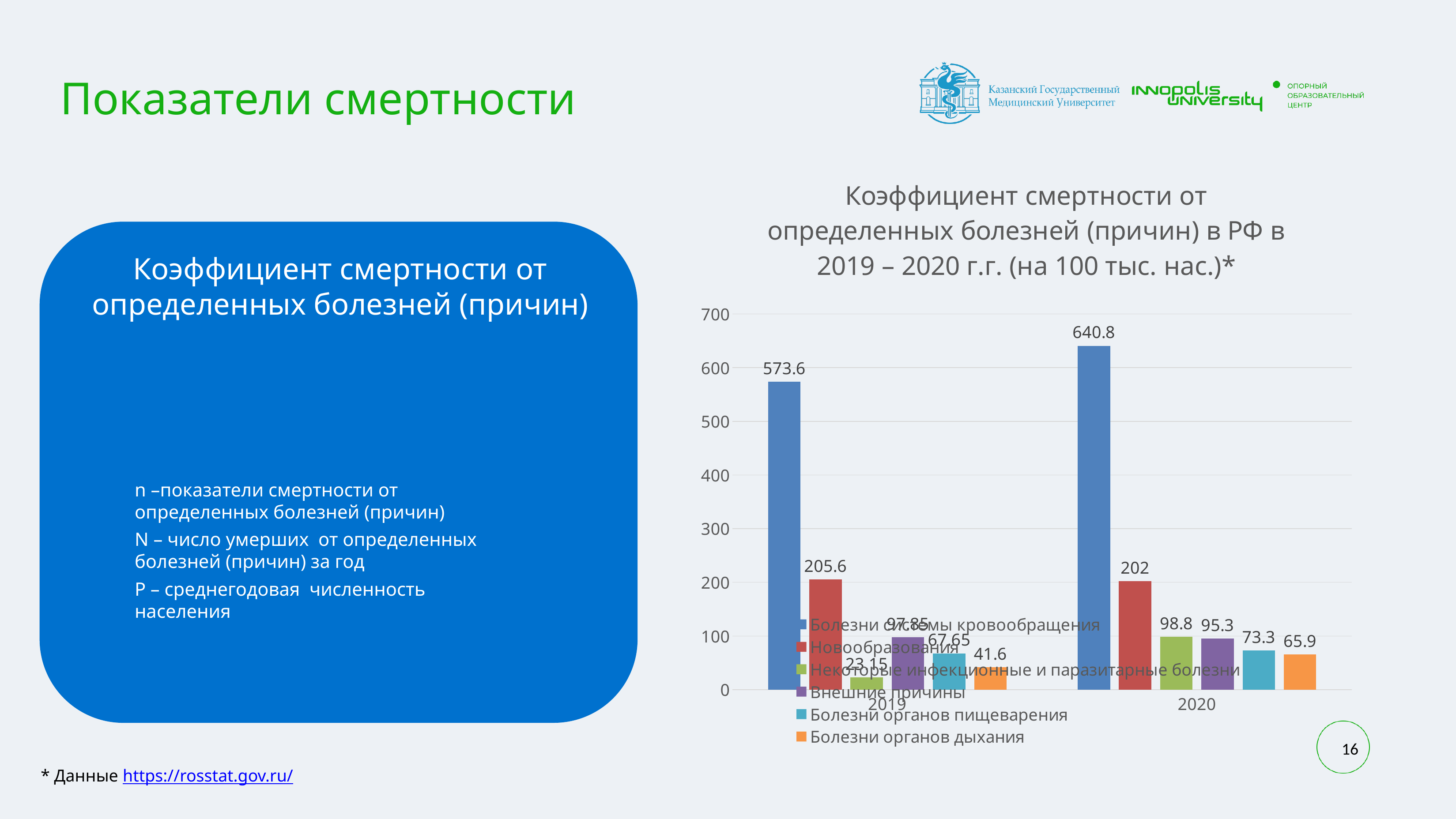
How many year categories are shown on the x axis? 2 What is the value for Болезни органов дыхания in 2020? 65.9 What is the difference between the values for Болезни системы кровообращения in 2020 and 2019? 67.2 Which is larger: Новообразования in 2019 or Новообразования in 2020? 2019 What is the value for Болезни органов пищеварения in 2019? 67.65 What type of chart is shown on the slide? bar chart What is the value for Болезни системы кровообращения in 2019? 573.6 Which series has the lowest value in 2019? Некоторые инфекционные и паразитарные болезни What is the value for Болезни системы кровообращения in 2020? 640.8 Which series has the highest value in 2020? Болезни системы кровообращения How many series does the legend list? 6 What is the value for Новообразования in 2019? 205.6